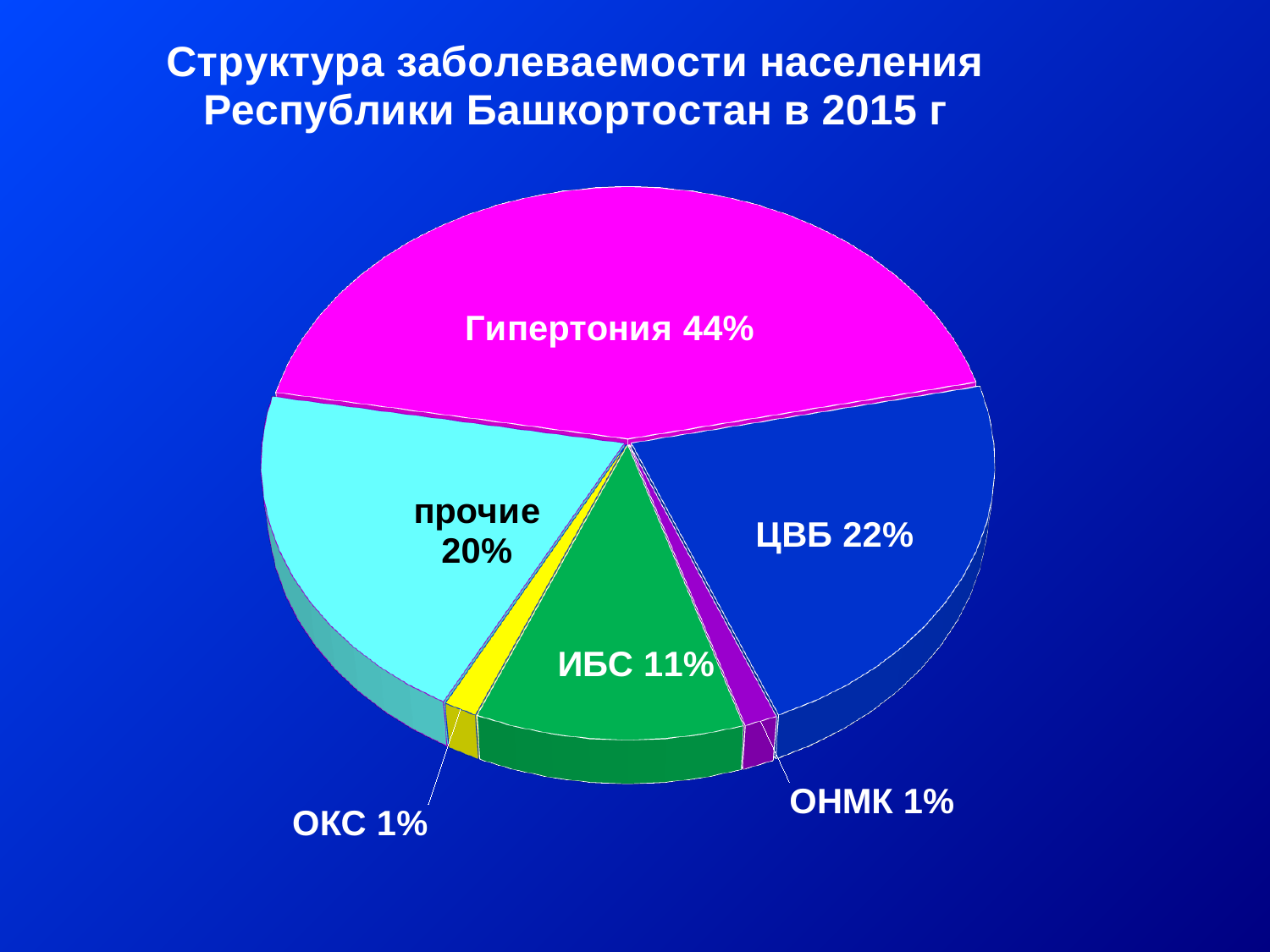
What is the difference between the shares of ЦВБ and ИБС? 11% Which category has the largest slice of the pie? Гипертония What kind of chart is shown on the slide? Pie chart What colour is the slice for Гипертония? Magenta What is the value shown for прочие? 20% How many slices does the pie chart have? 6 What is the value shown for ИБС? 11% Which is larger, the share of прочие or the share of ИБС? прочие What is the value shown for ЦВБ? 22% What is the title of the chart? Структура заболеваемости населения Республики Башкортостан в 2015 г What is the difference between the shares of Гипертония and ЦВБ? 22% What share of the pie does Гипертония account for? 44%